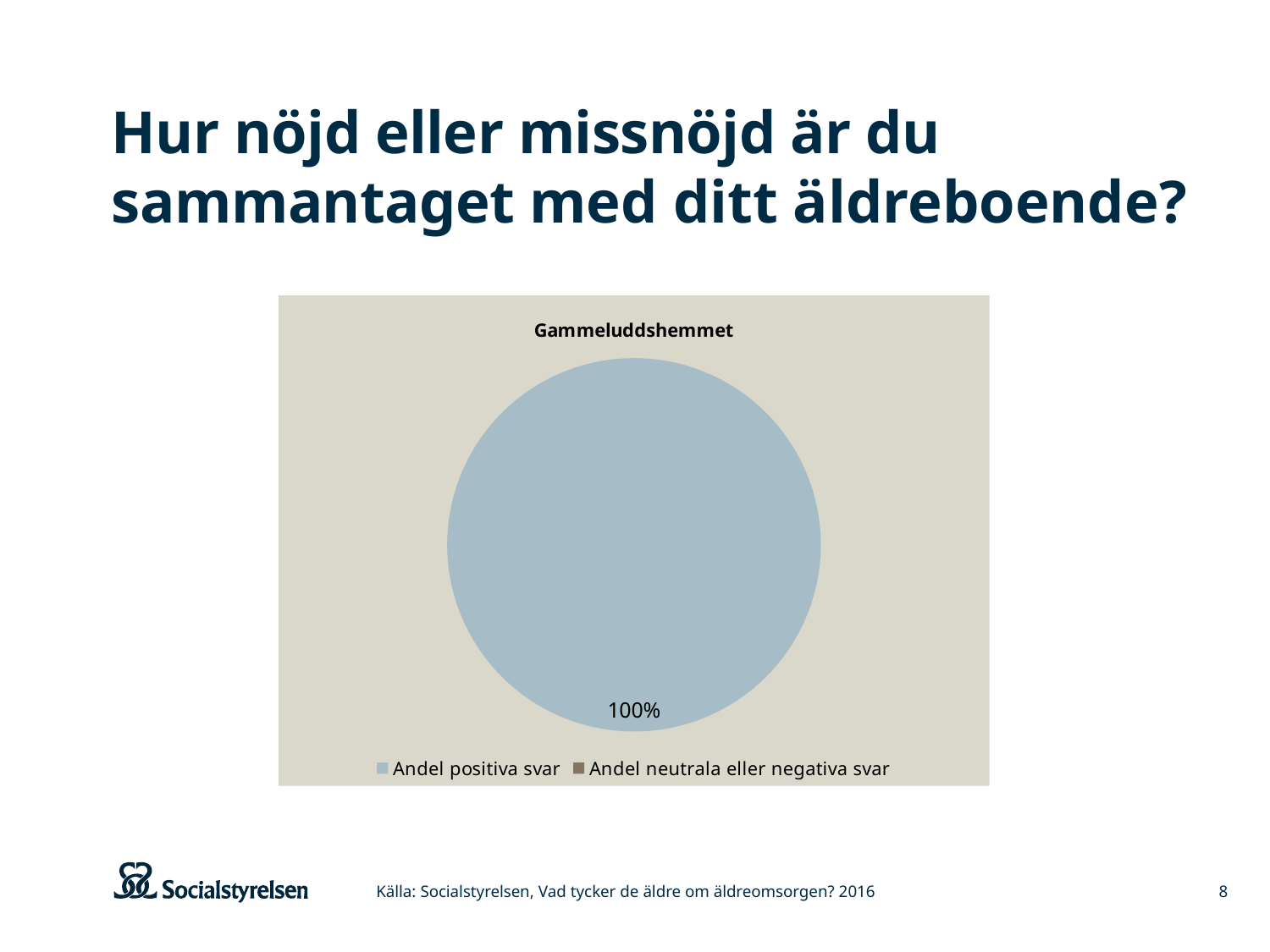
What value is printed as the data label on the pie chart? 100% How many entries does the legend list? 2 Which is larger, the share for Andel positiva svar or the share for Andel neutrala eller negativa svar? Andel positiva svar How many slices are visible in the pie chart? 1 Is the share for Andel positiva svar greater or less than 50%? greater What kind of chart is shown on the slide? pie chart What share of the pie is labelled for Andel positiva svar? 100% Which category has the largest share of the pie? Andel positiva svar What is the title of the chart? Gammeluddshemmet What are the two legend entries of the chart? Andel positiva svar; Andel neutrala eller negativa svar